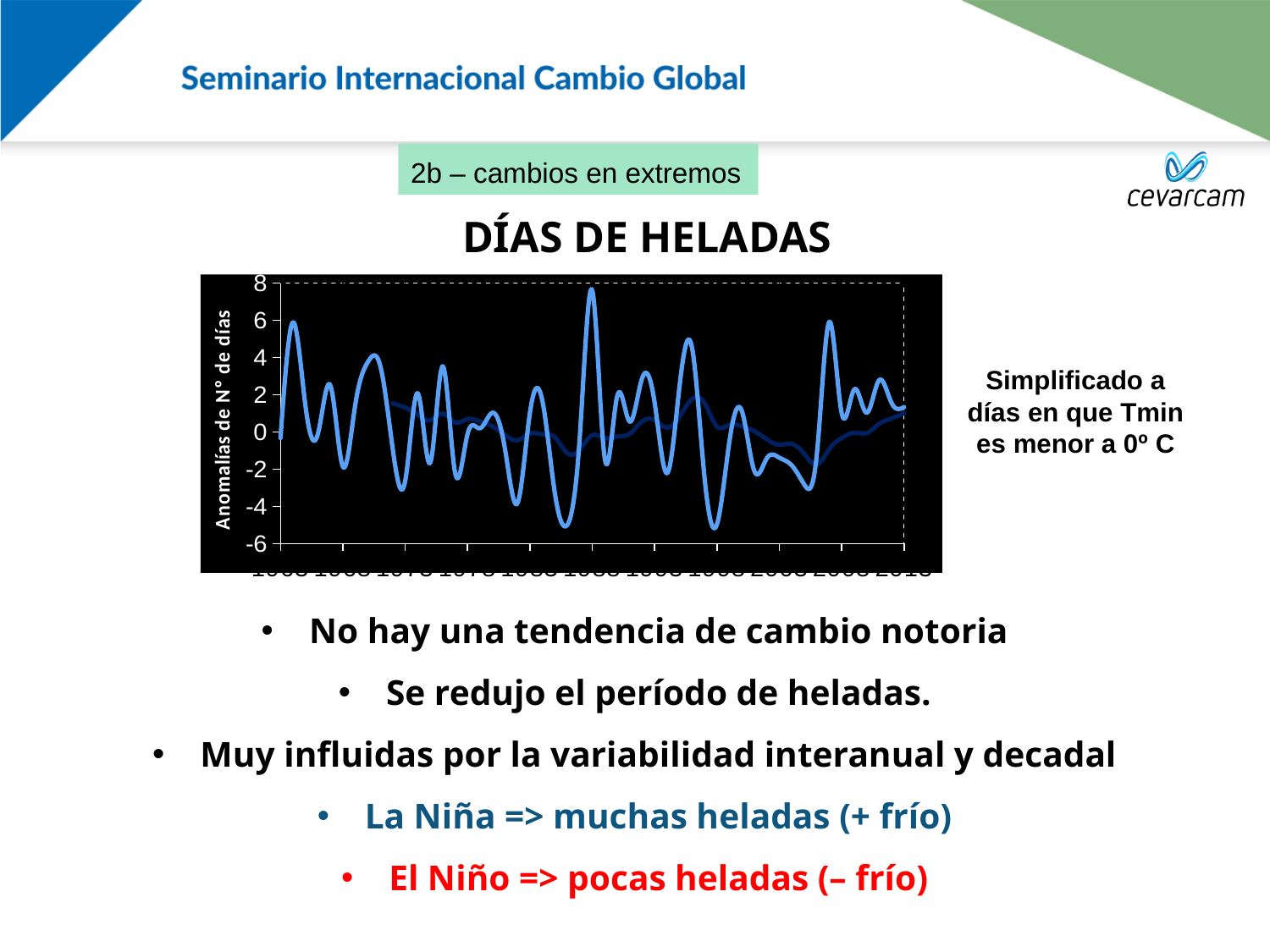
What is the title of the chart? DÍAS DE HELADAS How many lines are plotted on the chart? 2 What is the label of the y axis of the chart? Anomalías de N° de días Is the highest value reached by the light blue line greater or less than 6? greater Which line reaches a higher peak, the light blue line or the dark blue line? the light blue line Which line reaches a lower minimum, the light blue line or the dark blue line? the light blue line Is the highest value reached by the dark blue line greater or less than 4? less Is the lowest value reached by the light blue line greater or less than -4? less What kind of chart is shown on the slide? line chart